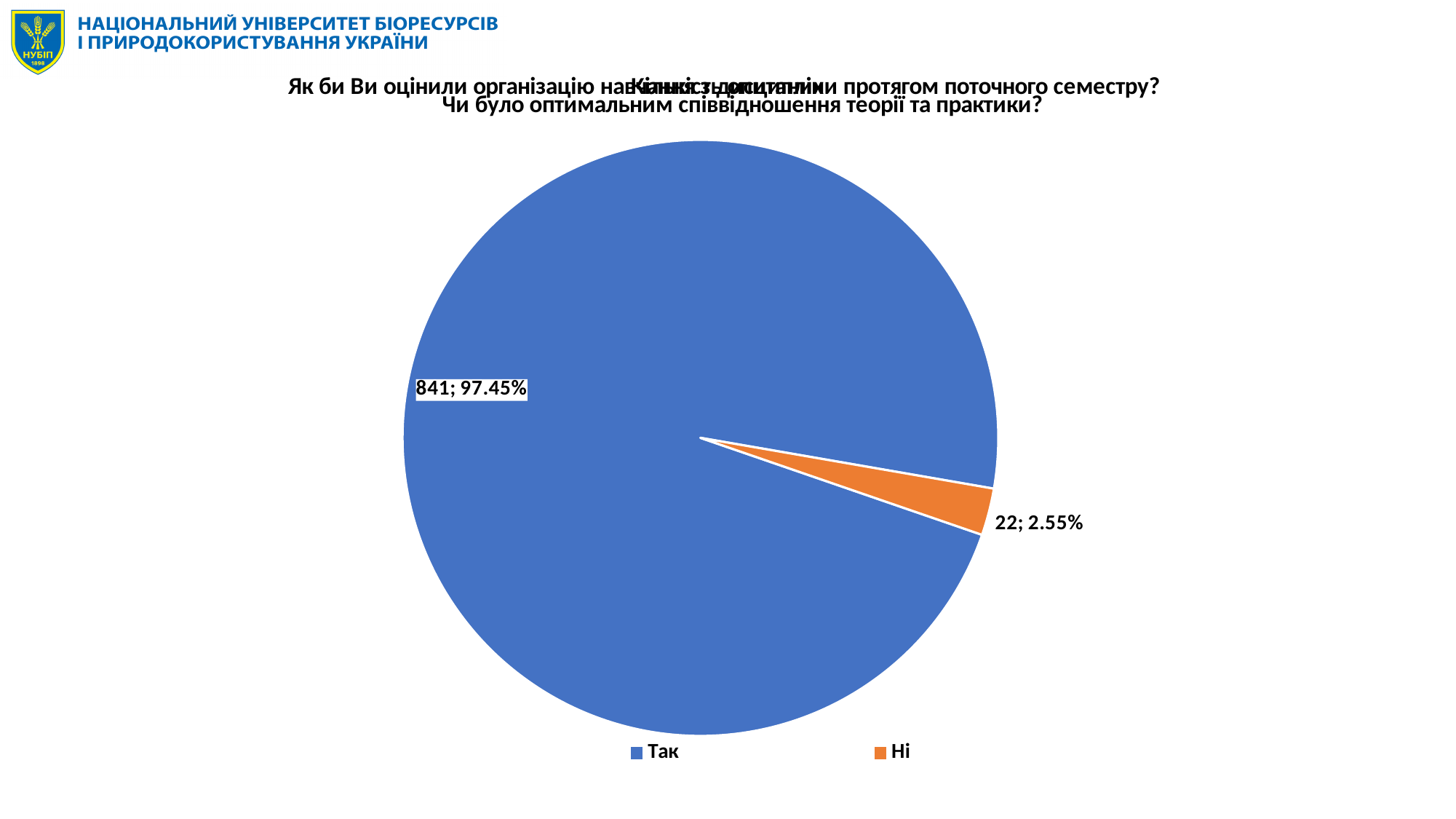
Which slice is the largest in the pie chart? Так What share of the pie does the "Так" slice represent? 97.45% What share of the pie does the "Ні" slice represent? 2.55% What is the difference between the counts for "Так" and "Ні"? 819 What is the count shown for the "Так" slice? 841 What is the count shown for the "Ні" slice? 22 How many entries does the legend of the pie chart list? 2 Which slice is the smallest in the pie chart? Ні Which is larger, the value for "Так" or the value for "Ні"? Так What kind of chart is shown on the slide? pie chart How many slices does the pie chart have? 2 What colour is the "Ні" slice in the pie chart? orange